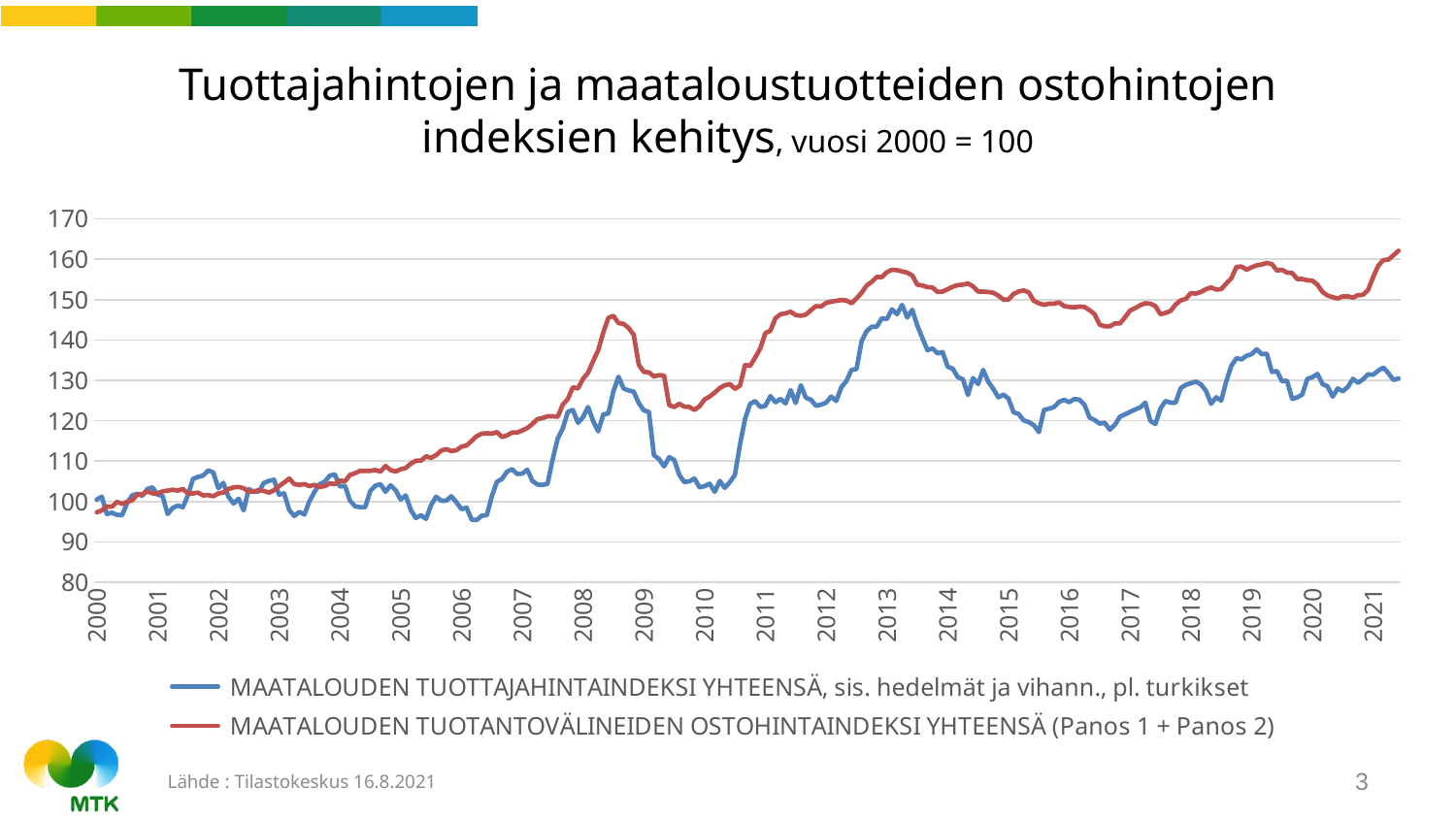
What kind of chart is shown on the slide? line chart What base year and value does the title state for the indices? vuosi 2000 = 100 How many year labels are shown on the x axis? 22 At the end of 2021, which series has the higher value, the blue tuottajahintaindeksi or the red ostohintaindeksi? the red ostohintaindeksi Is the peak of the blue series (tuottajahintaindeksi) around 2013 greater or less than 140? greater How many series does the legend list? 2 Overall, does the red series (ostohintaindeksi) rise or fall from 2000 to 2021? rise Is the value of the red series (ostohintaindeksi) at the end of 2021 greater or less than 150? greater Which series is drawn in red? MAATALOUDEN TUOTANTOVÄLINEIDEN OSTOHINTAINDEKSI YHTEENSÄ (Panos 1 + Panos 2) Is the value of the blue series (tuottajahintaindeksi) at the end of 2021 greater or less than 140? less Does the blue series (tuottajahintaindeksi) rise or fall between its 2013 peak and 2015? fall